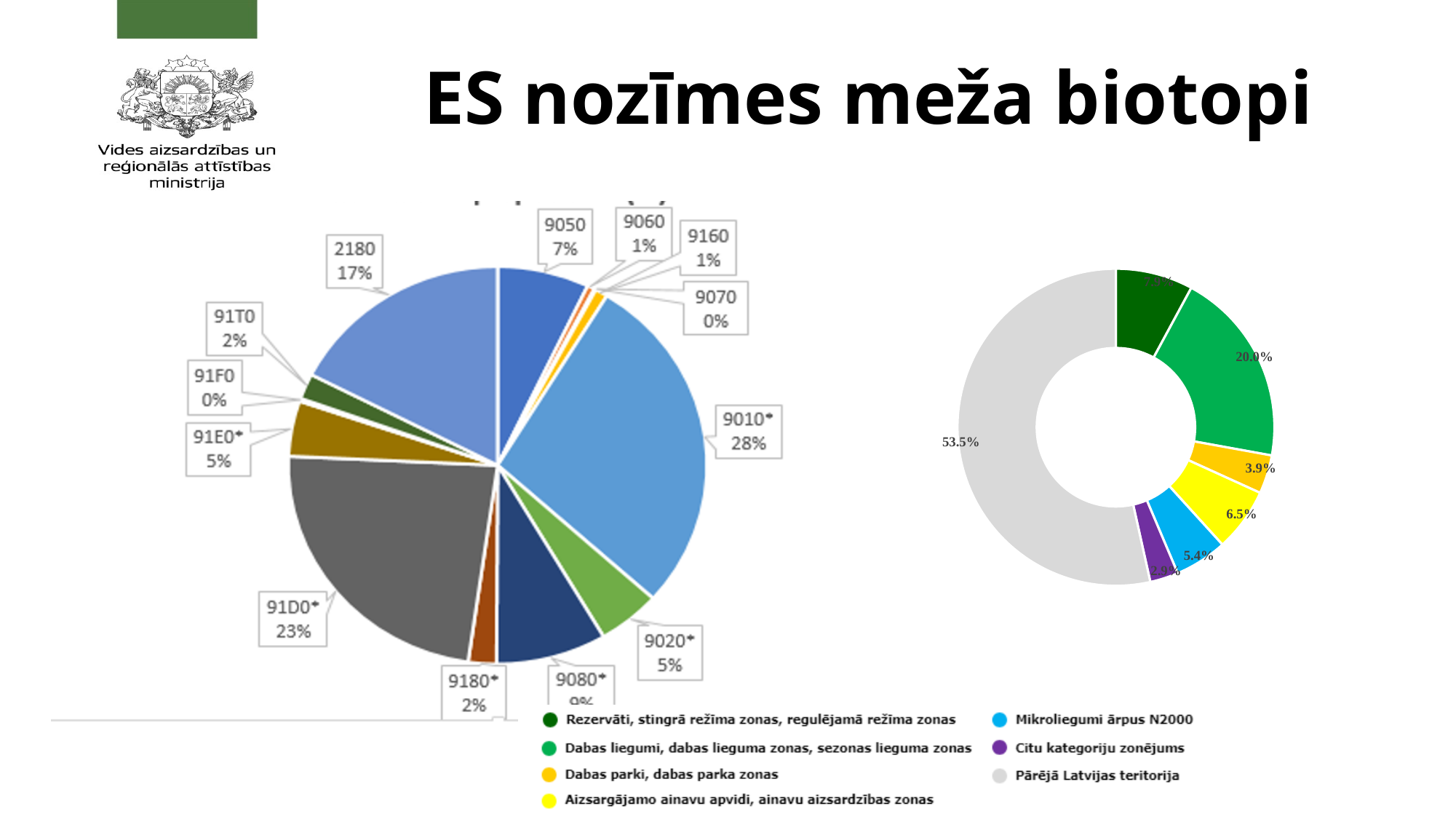
In the right doughnut chart, what percentage is shown for Dabas liegumi, dabas lieguma zonas, sezonas lieguma zonas? 20.0% How many entries does the legend of the right doughnut chart list? 7 In the left pie chart, which has the larger share, 2180 or 9050? 2180 In the right doughnut chart, what percentage is shown for Pārējā Latvijas teritorija? 53.5% In the right doughnut chart, what percentage is shown for Aizsargājamo ainavu apvidi, ainavu aizsardzības zonas? 6.5% In the left pie chart, which habitat code has the largest share? 9010* In the right doughnut chart, which category has the largest share? Pārējā Latvijas teritorija In the left pie chart, what percentage is shown for 91D0*? 23% In the left pie chart, what is the difference in percentage points between 9010* and 91D0*? 5 percentage points In the left pie chart, how many habitat codes are labelled? 13 In the left pie chart, what percentage is shown for 9010*? 28% In the left pie chart, what percentage is shown for 2180? 17%